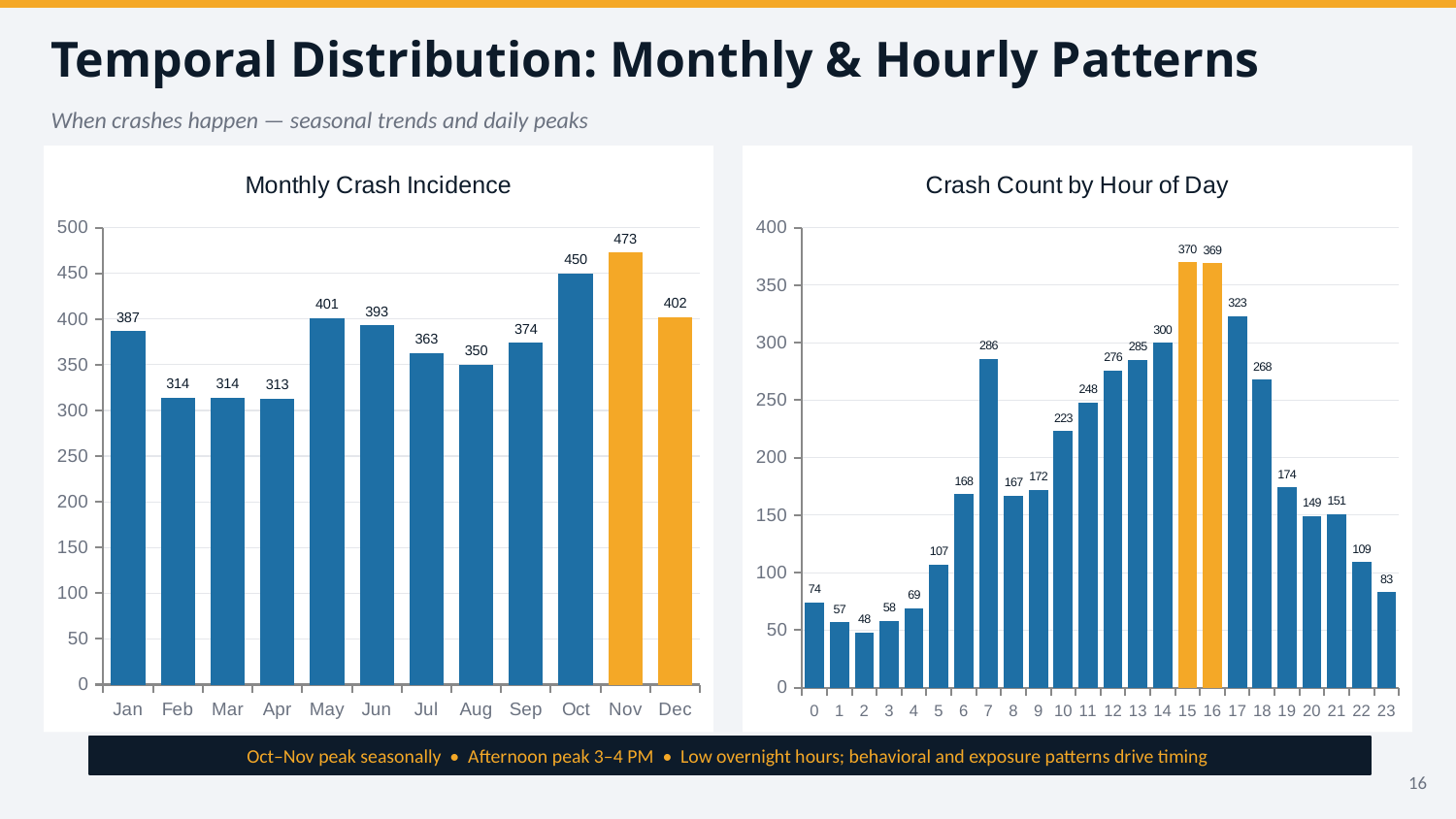
In the Crash Count by Hour of Day chart, what is the difference between hour 17 and hour 18? 55 In the Monthly Crash Incidence chart, how many months are shown on the x axis? 12 In the Monthly Crash Incidence chart, which is larger, May or Jun? May In the Crash Count by Hour of Day chart, what is the value for hour 7? 286 In the Monthly Crash Incidence chart, what is the difference between Oct and Sep? 76 In the Crash Count by Hour of Day chart, which hour has the highest value? 15 In the Monthly Crash Incidence chart, which two bars are coloured orange? Nov and Dec What kind of chart is Crash Count by Hour of Day? Bar chart In the Monthly Crash Incidence chart, what is the value for Nov? 473 In the Crash Count by Hour of Day chart, do the values rise or fall from hour 17 to hour 23? Fall In the Monthly Crash Incidence chart, which month has the lowest value? Apr In the Crash Count by Hour of Day chart, which hour has the lowest value? 2